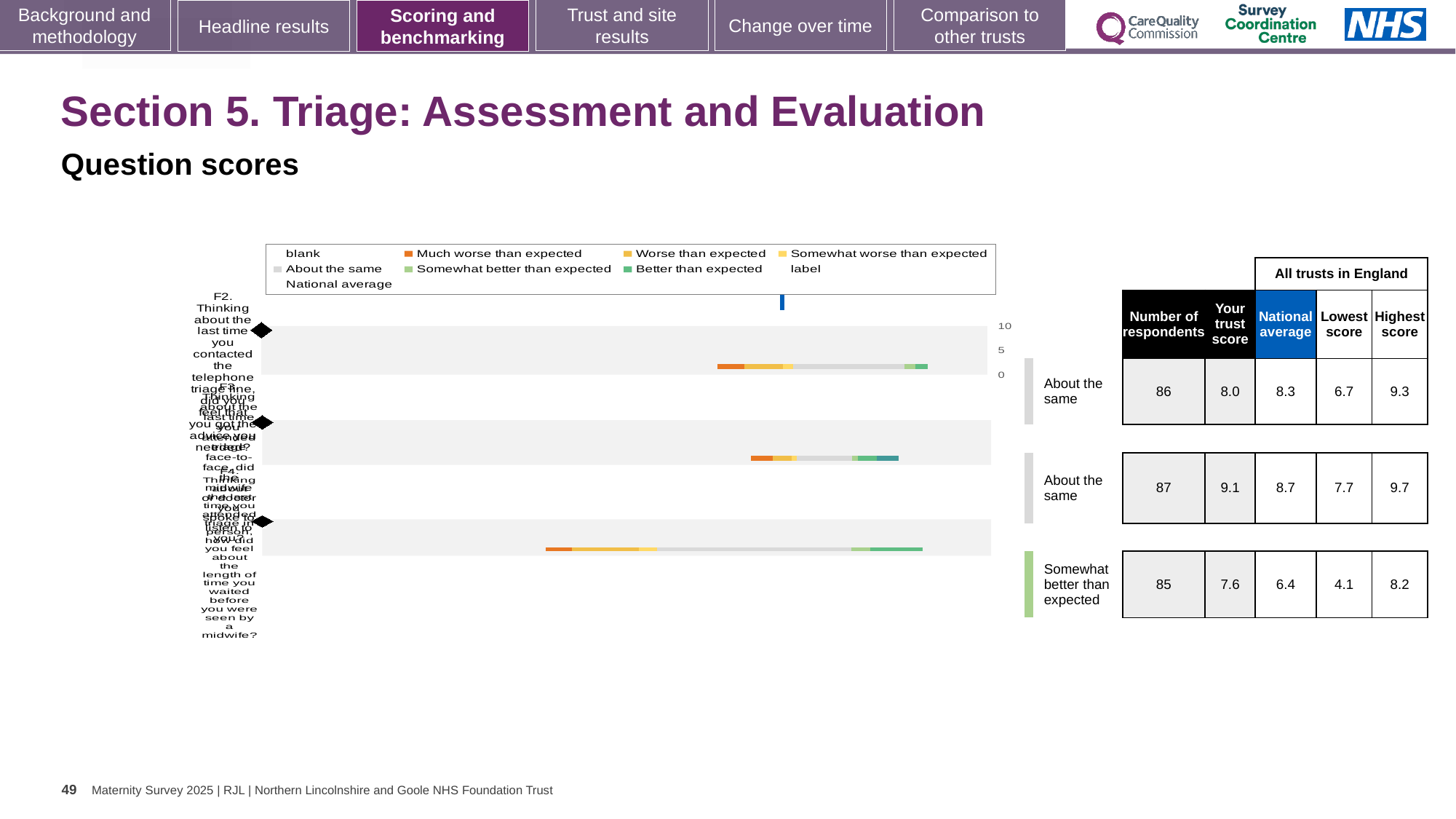
In the table beside the chart, which row has the lowest national average? the third row (F4), 6.4 What kind of chart is shown on the slide? bar chart In the table beside the chart, what is the difference between the trust score and the national average for the third row (F4)? 1.2 In the table beside the chart, is the trust score for the first row (F2) larger or smaller than its national average? smaller In the table beside the chart, what is the number of respondents for the third row (F4)? 85 In the table beside the chart, what is the trust score for the first row (F2)? 8.0 How many question rows (bars) are plotted in the chart? 3 In the table beside the chart, what is the national average for the second row (F3)? 8.7 In the table beside the chart, which row has the highest trust score? the second row (F3), 9.1 In the chart legend, which entry is shown in orange? Much worse than expected What benchmark category is given for the third row (F4)? Somewhat better than expected What is the highest tick value shown on the chart's numeric axis? 10